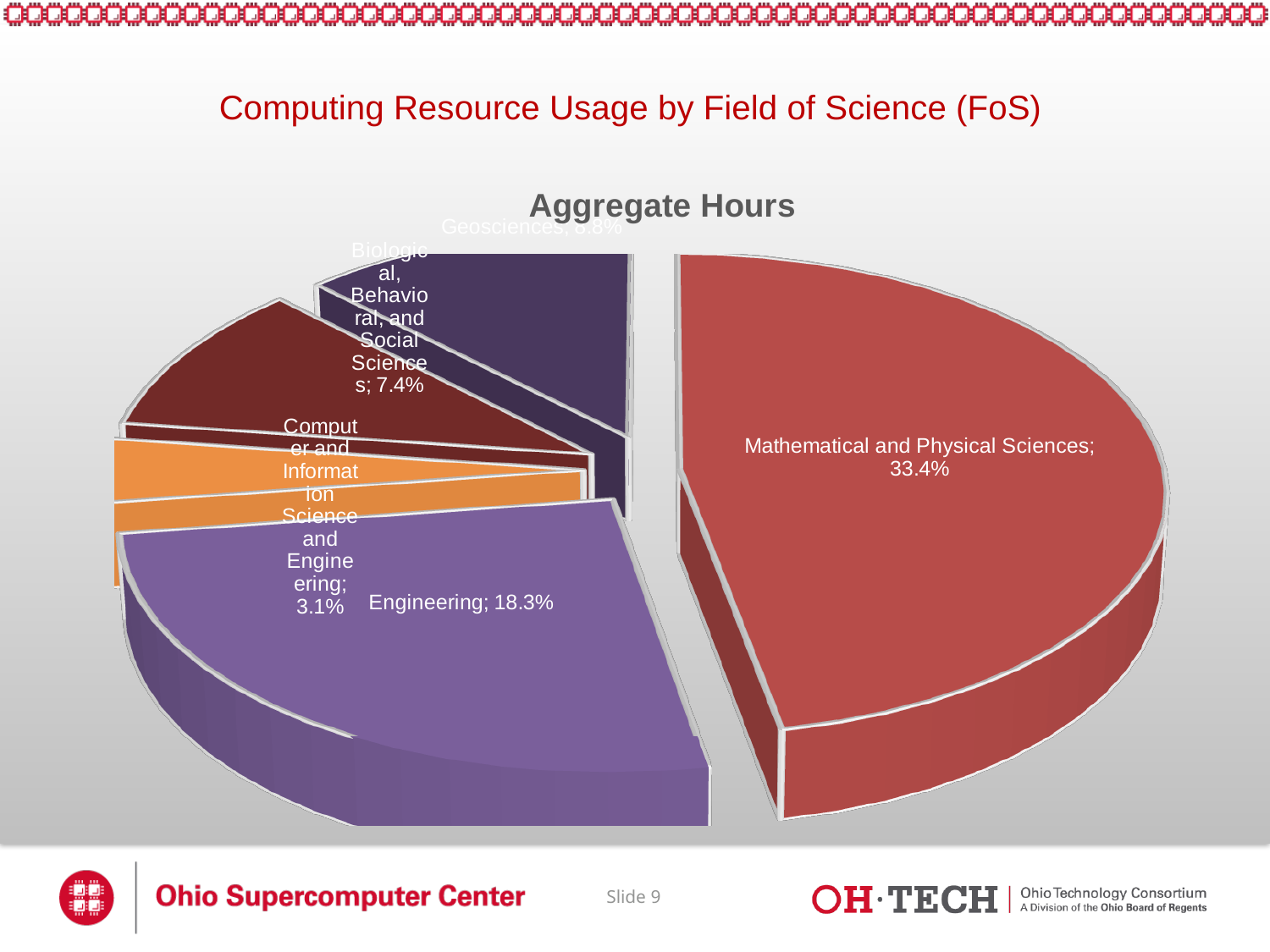
What share of aggregate hours is used by Computer and Information Science and Engineering? 3.1% What colour is the Mathematical and Physical Sciences slice? Red How many percentage points larger is the Engineering share than the Computer and Information Science and Engineering share? 15.2 percentage points What kind of chart is shown on the slide? Pie chart How many percentage points larger is the Mathematical and Physical Sciences share than the Engineering share? 15.1 percentage points What is the title of the chart? Aggregate Hours What share of aggregate hours is used by Biological, Behavioral, and Social Sciences? 7.4% Which field of science has the largest share of aggregate hours? Mathematical and Physical Sciences What share of aggregate hours is used by Engineering? 18.3% Which has a larger share of aggregate hours, Engineering or Biological, Behavioral, and Social Sciences? Engineering Which has a larger share of aggregate hours, Computer and Information Science and Engineering or Biological, Behavioral, and Social Sciences? Biological, Behavioral, and Social Sciences What share of aggregate hours is used by Mathematical and Physical Sciences? 33.4%